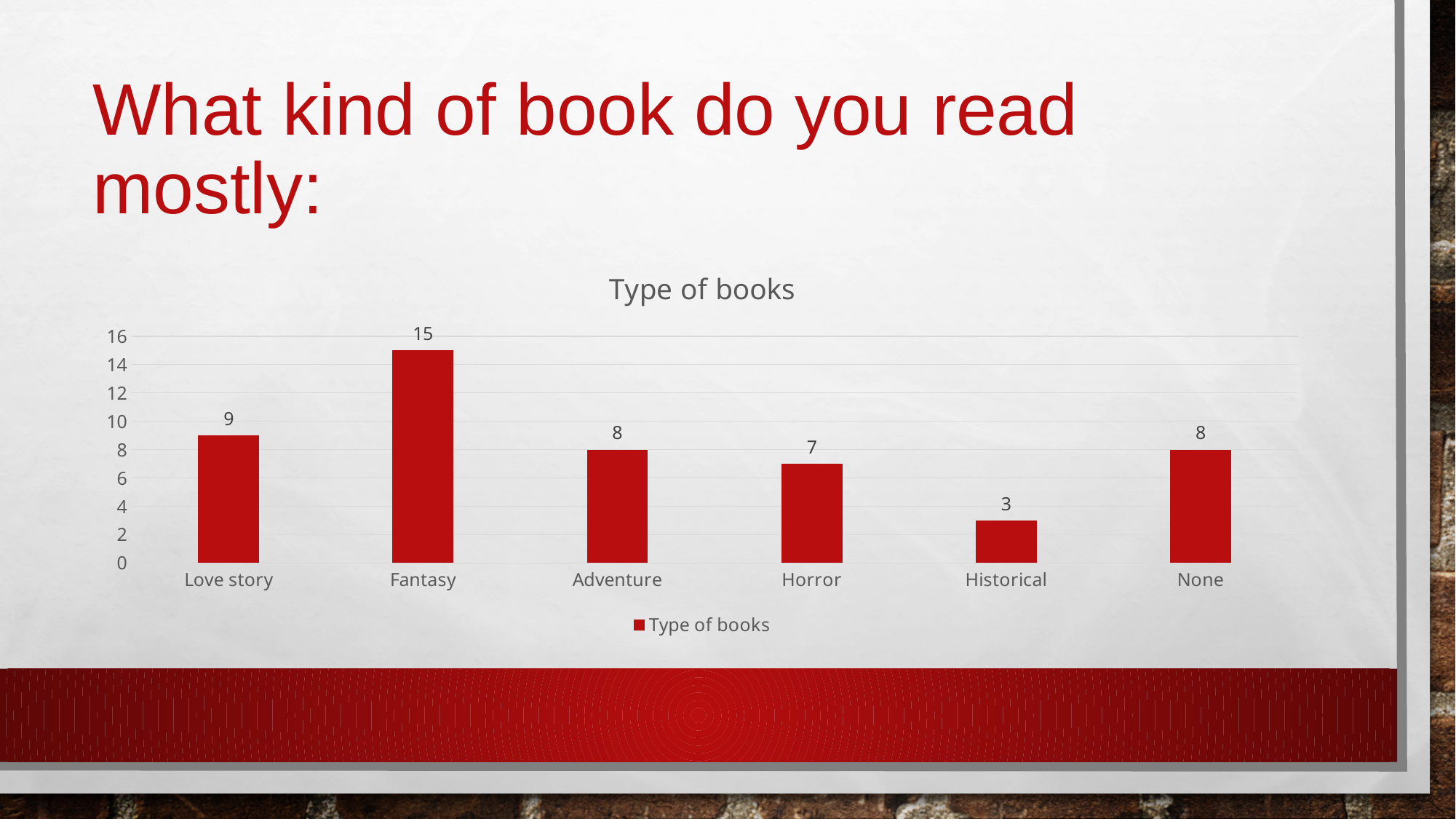
Which is larger, the value for Love story or the value for Adventure? Love story What kind of chart is shown? bar chart How many categories are shown on the x axis? 6 Which category has the highest value? Fantasy What is the value for Fantasy? 15 What is the title of the chart? Type of books Which category has the lowest value? Historical What is the value for Love story? 9 What is the value for Historical? 3 Is the value for Fantasy greater or less than 12? greater What is the difference between the values for Fantasy and Horror? 8 How many series does the legend list? 1